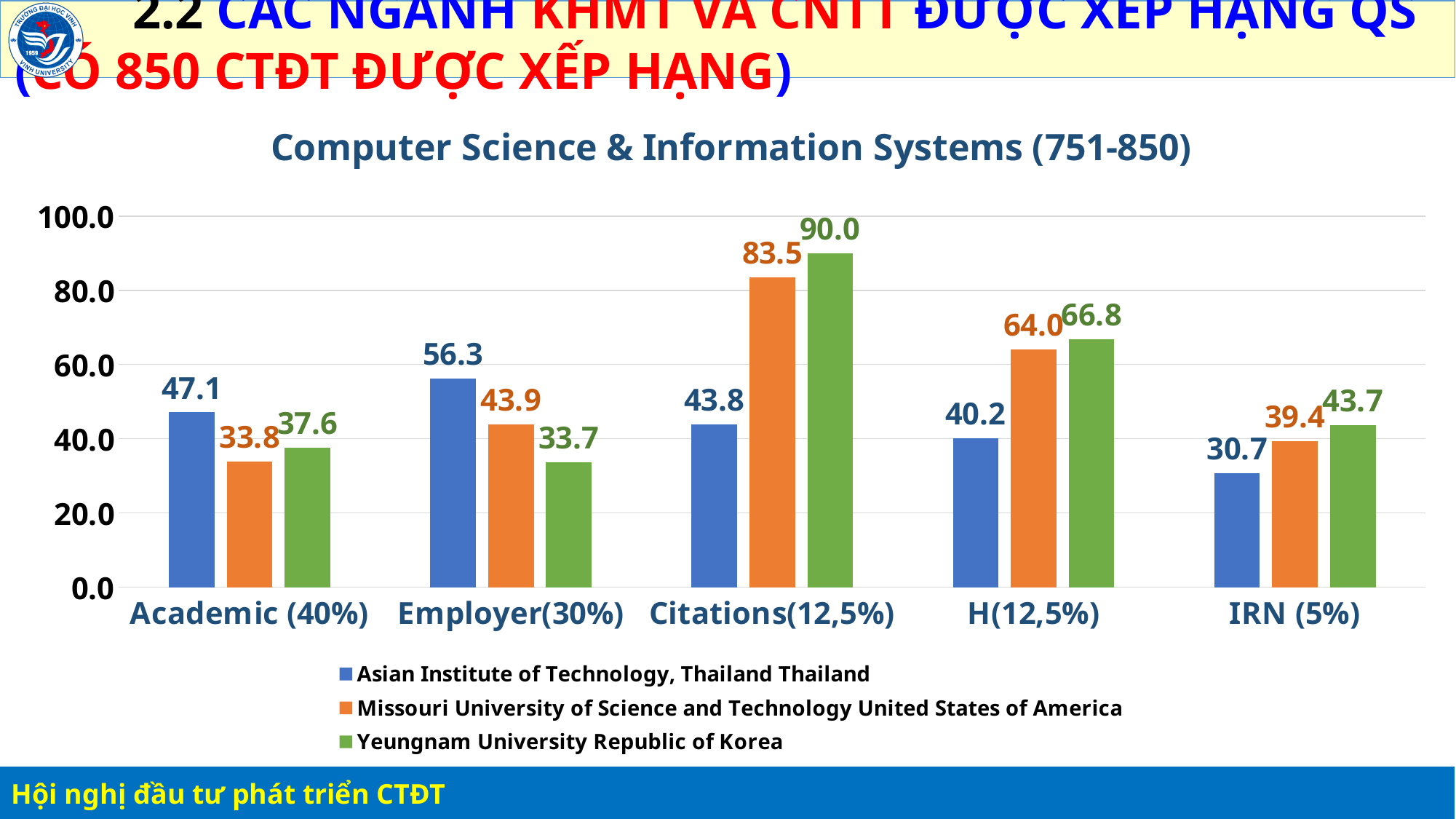
What is the value for Yeungnam University in the Citations(12,5%) category? 90.0 What is the value for Asian Institute of Technology in the Academic (40%) category? 47.1 How many series does the legend list? 3 What kind of chart is shown on the slide? Bar chart What is the title of the chart? Computer Science & Information Systems (751-850) What is the value for Asian Institute of Technology in the IRN (5%) category? 30.7 What is the difference between Yeungnam University and Missouri University of Science and Technology in the Citations(12,5%) category? 6.5 In which category does Yeungnam University have its lowest value? Employer(30%) In which category does Asian Institute of Technology have its highest value? Employer(30%) How many categories are shown on the x axis? 5 Which is larger in the Employer(30%) category: Asian Institute of Technology or Missouri University of Science and Technology? Asian Institute of Technology What is the value for Missouri University of Science and Technology in the H(12,5%) category? 64.0